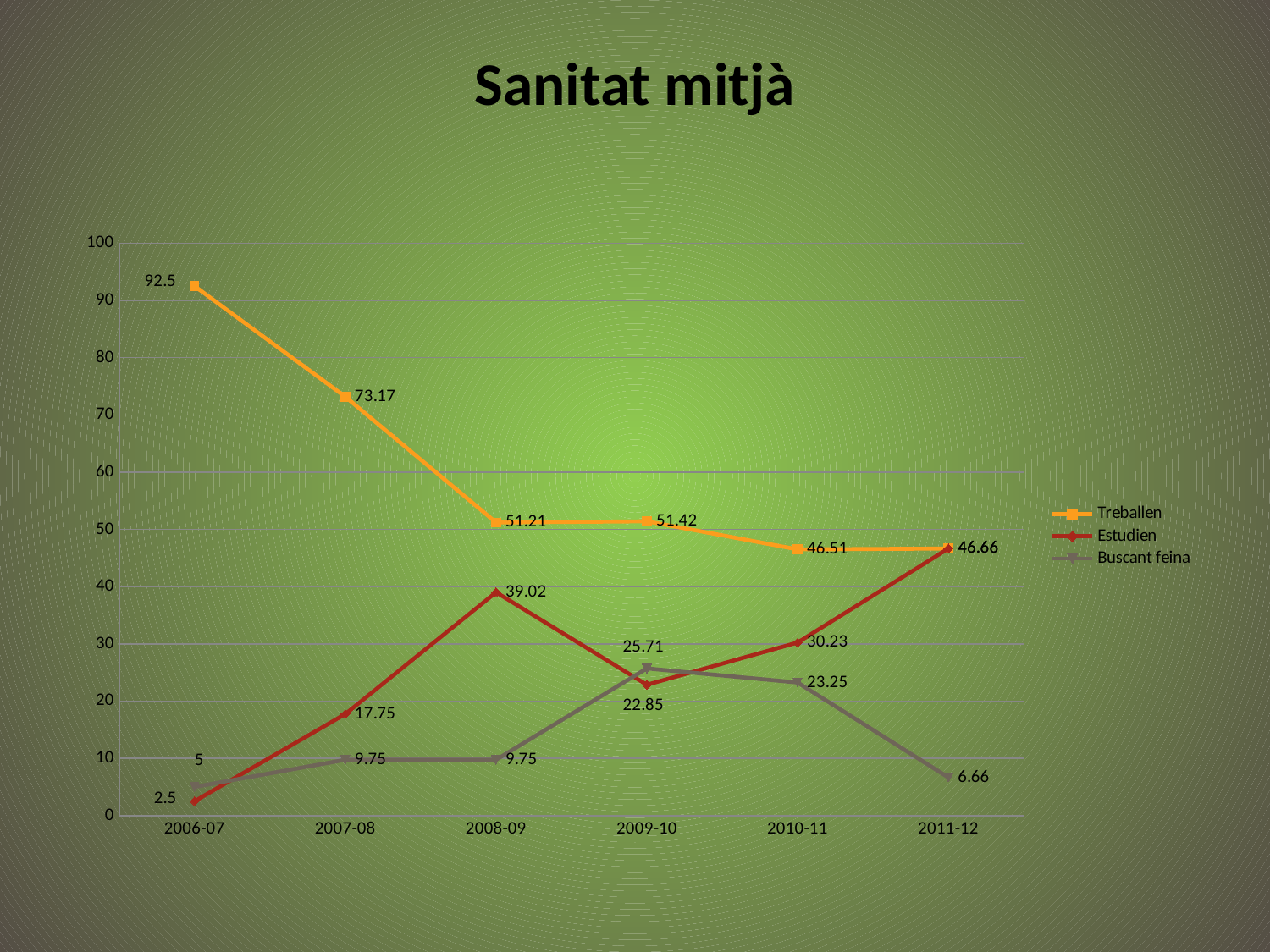
Does the Treballen series generally rise or fall from 2006-07 to 2011-12? fall How many series does the legend list? 3 What type of chart is shown on the slide? line chart What is the value for Buscant feina in 2009-10? 25.71 What is the difference between the Treballen values in 2006-07 and 2007-08? 19.33 What is the value for Estudien in 2008-09? 39.02 In which period is the Estudien value lowest? 2006-07 In which period is the Treballen value highest? 2006-07 Which is larger in 2010-11, Estudien or Buscant feina? Estudien What is the title of the chart? Sanitat mitjà What is the value for Treballen in 2006-07? 92.5 How many periods are shown on the x axis? 6